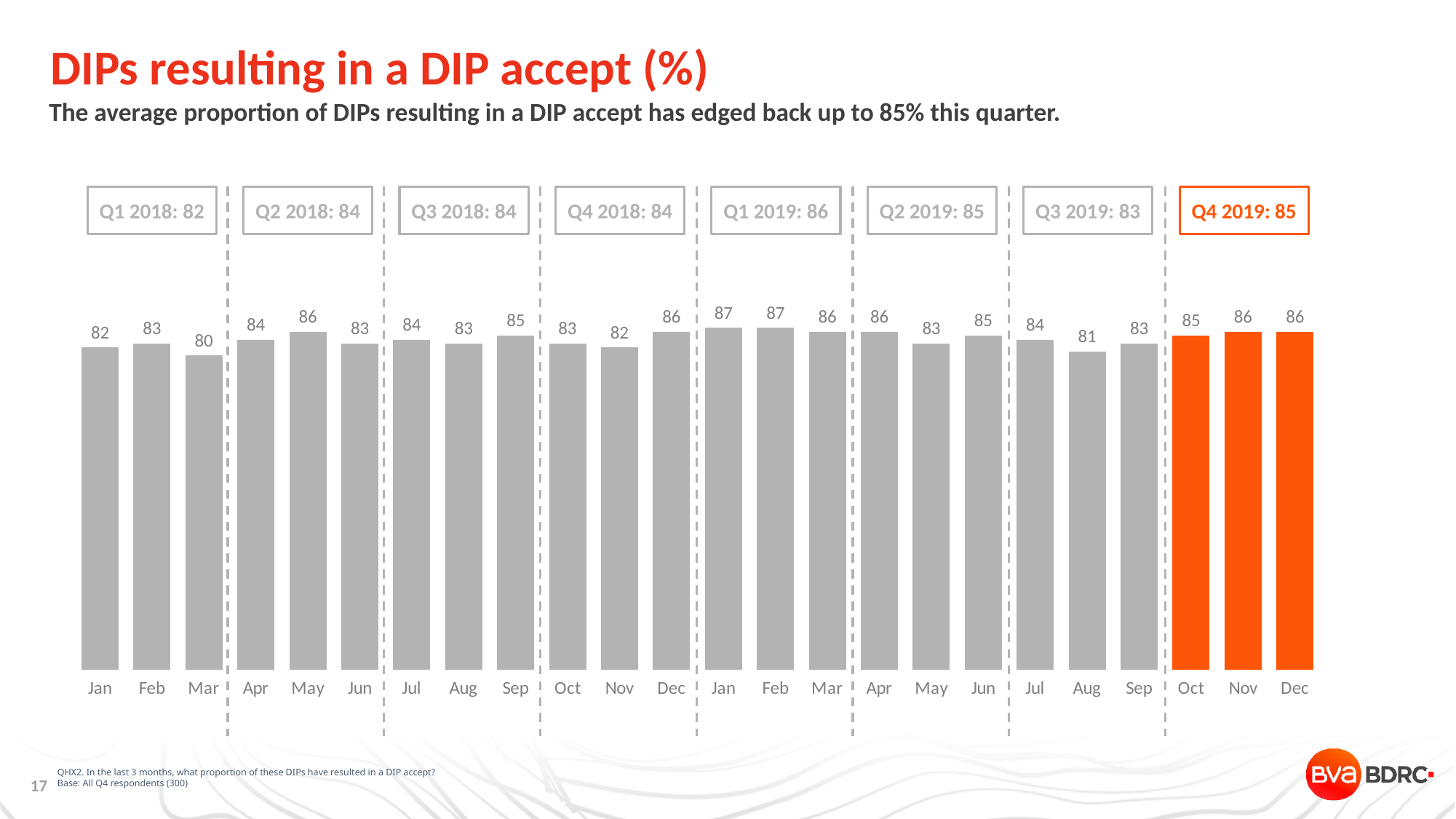
What is the highest value shown on any bar? 87 What kind of chart is shown on the slide? Bar chart Which month has the lowest value on the chart? Mar 2018 Which is larger, the value for Nov 2018 or the value for Dec 2018? Dec 2018 What is the difference between the values for May 2018 and Jun 2018? 3 What is the value for Aug 2019 (in Q3 2019)? 81 Which quarter's bars are highlighted in orange? Q4 2019 How many monthly bars are plotted on the chart? 24 What is the quarterly average shown for Q1 2019? 86 What is the value for Mar 2018 (in Q1 2018)? 80 What is the value for Dec 2019 (in Q4 2019)? 86 What is the difference between the quarterly averages for Q3 2019 and Q4 2019? 2